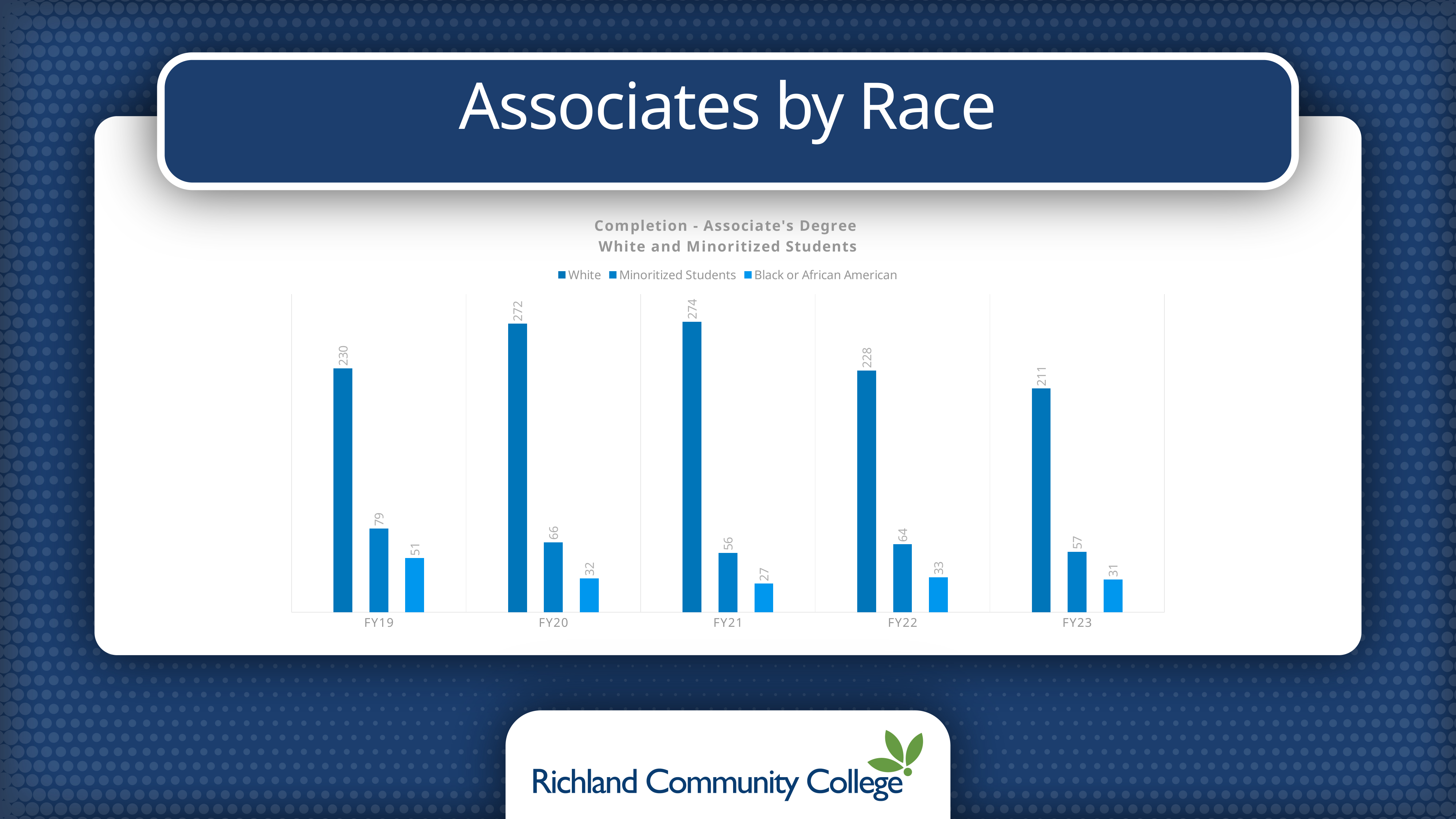
What is the value for Black or African American in FY22? 33 What kind of chart is shown on the slide? Bar chart In which fiscal year is the Black or African American series lowest? FY21 How many series does the legend list? 3 In which fiscal year is the White series highest? FY21 Does the White series rise or fall from FY21 to FY23? Fall Which is larger, Minoritized Students in FY20 or Minoritized Students in FY22? Minoritized Students in FY20 What is the value for White in FY21? 274 What is the title of the chart? Completion - Associate's Degree White and Minoritized Students How many fiscal years are shown on the x axis? 5 What is the value for Minoritized Students in FY19? 79 What is the difference between the White values for FY20 and FY23? 61